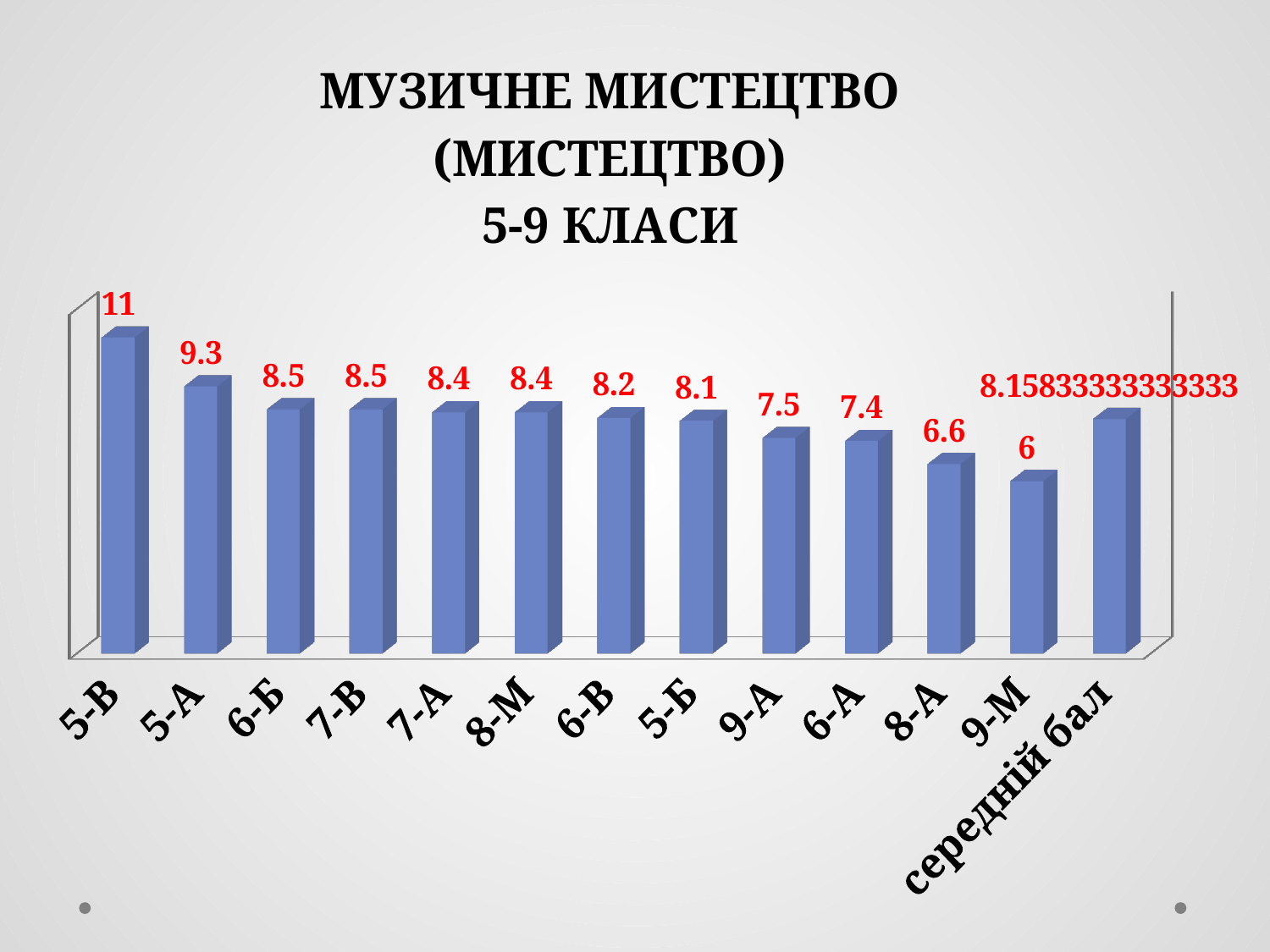
What is the value for class 5-В? 11 What is the value shown for середній бал? 8.15833333333333 What is the value for class 9-М? 6 Which category has the highest value? 5-В Which is larger, the value for 6-В or the value for 8-А? 6-В What is the title of the chart? МУЗИЧНЕ МИСТЕЦТВО (МИСТЕЦТВО) 5-9 КЛАСИ Which category has the lowest value? 9-М What is the value for class 8-А? 6.6 What is the difference between the values for 5-В and 5-А? 1.7 What is the difference between the values for 9-А and 6-А? 0.1 What kind of chart is shown on the slide? Bar chart How many categories are shown on the x axis? 13